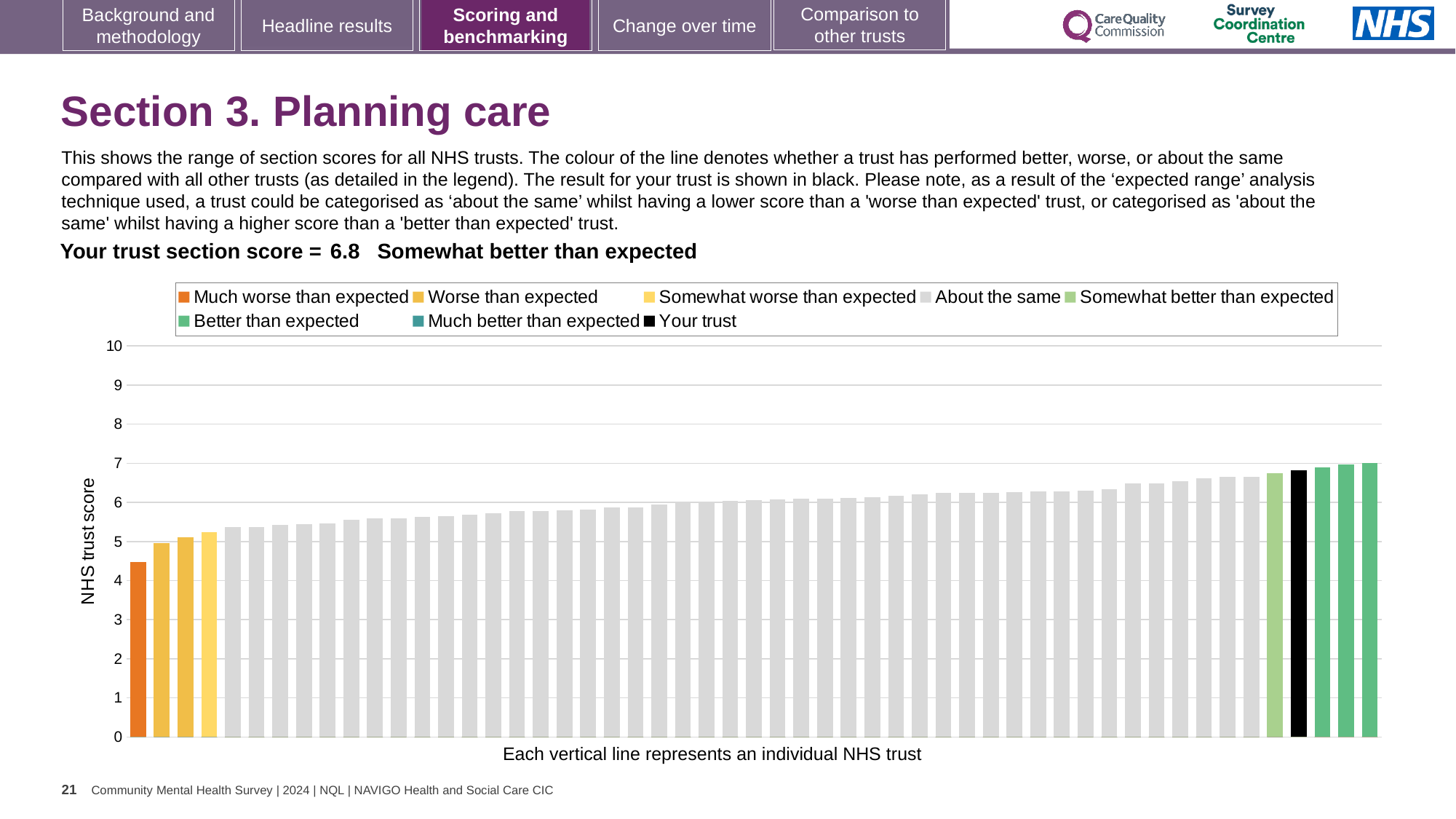
Is the value of the highest bar greater or less than 8? less Is your trust's section score greater or less than 6? greater What is the label on the vertical axis? NHS trust score What colour is used for the 'Your trust' bar? black Which legend category does the lowest-scoring trust belong to? Much worse than expected Which category does your trust fall into according to the text above the chart? Somewhat better than expected How many entries does the chart legend list? 8 Do the bar values rise or fall from left to right along the x axis? rise Is the value of the lowest bar (the orange bar) greater or less than 5? less What kind of chart is shown on the slide? bar chart How many bars are to the right of the black 'Your trust' bar? 3 What is your trust's section score for Planning care? 6.8